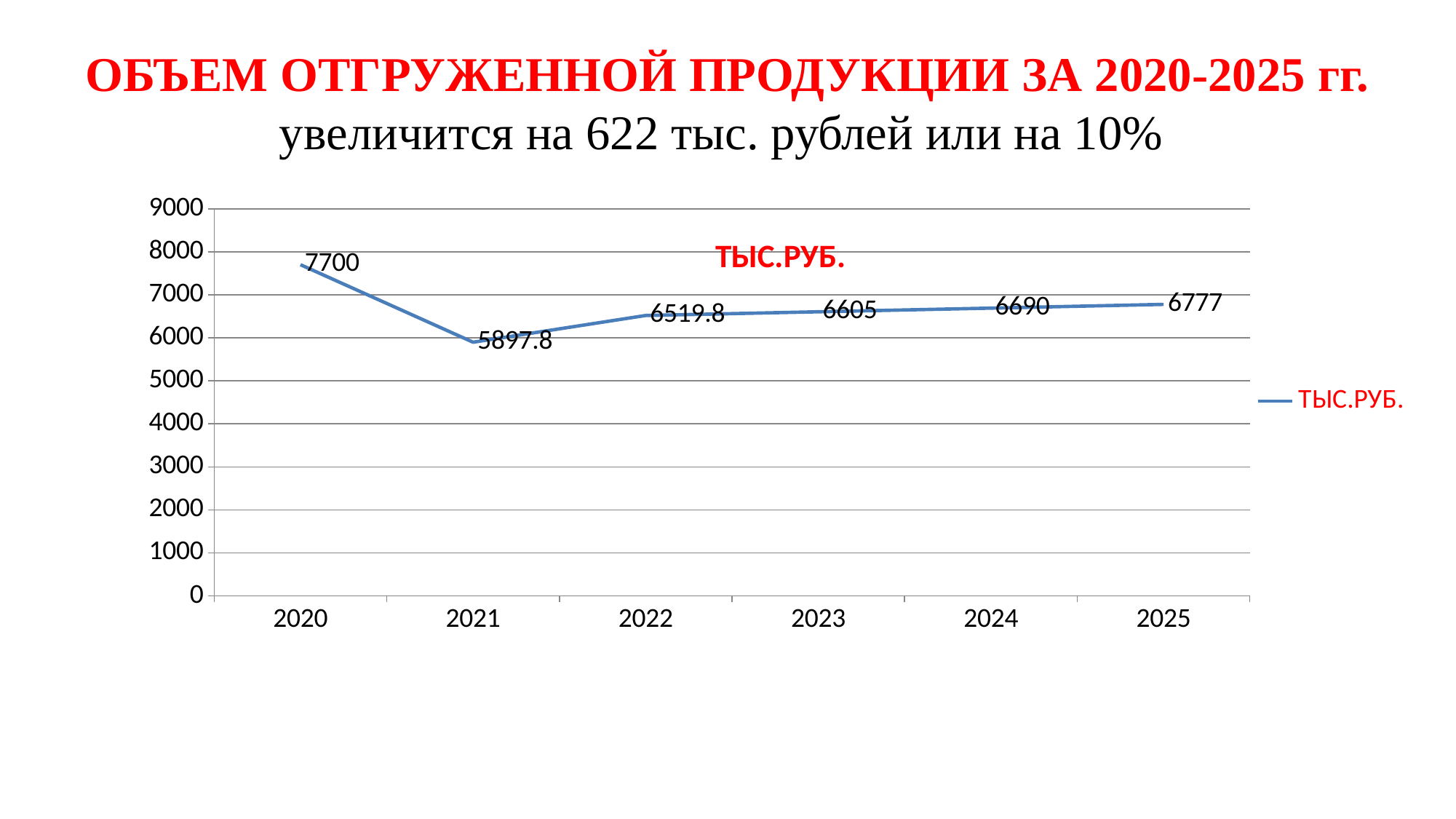
Is the value for 2021 greater or less than 6000? less What is the difference between the values for 2025 and 2024? 87 What is the value for 2020? 7700 Which is larger, the value for 2023 or the value for 2024? 2024 What kind of chart is shown? line chart What is the value for 2021? 5897.8 Which year has the lowest value? 2021 Which year has the highest value? 2020 How many years are plotted on the x axis? 6 What is the value for 2025? 6777 What is the value for 2022? 6519.8 What series name does the legend show? ТЫС.РУБ.